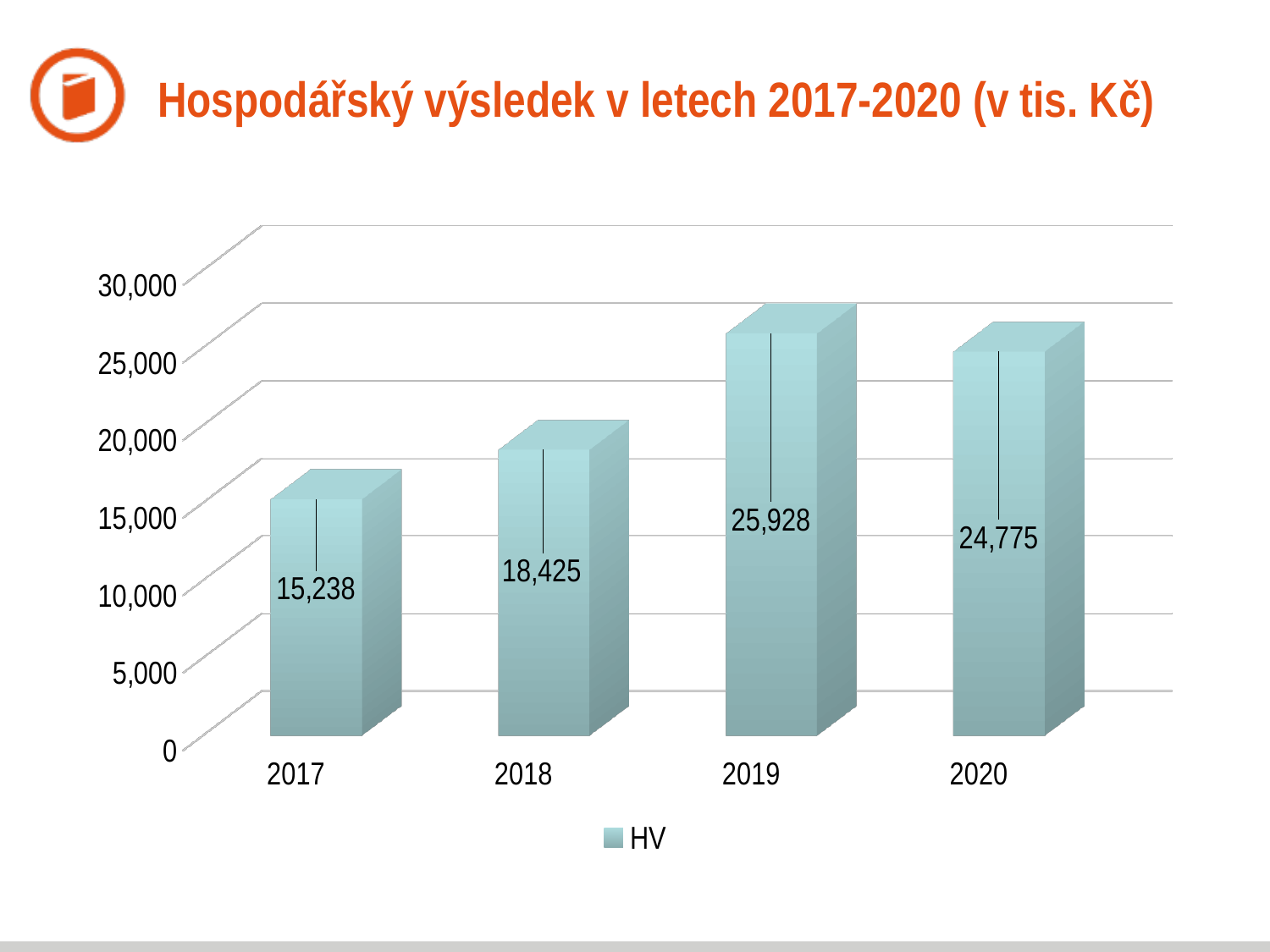
Which year has the highest value? 2019 How many years are shown on the chart? 4 What is the difference between the values for 2019 and 2020? 1,153 How many series does the legend list? 1 What kind of chart is shown on the slide? bar chart Which year has the lowest value? 2017 What is the value for 2017? 15,238 What is the value for 2020? 24,775 What is the difference between the values for 2018 and 2017? 3,187 Which is larger, the value for 2018 or the value for 2020? 2020 What is the name of the series in the legend? HV What is the value for 2019? 25,928